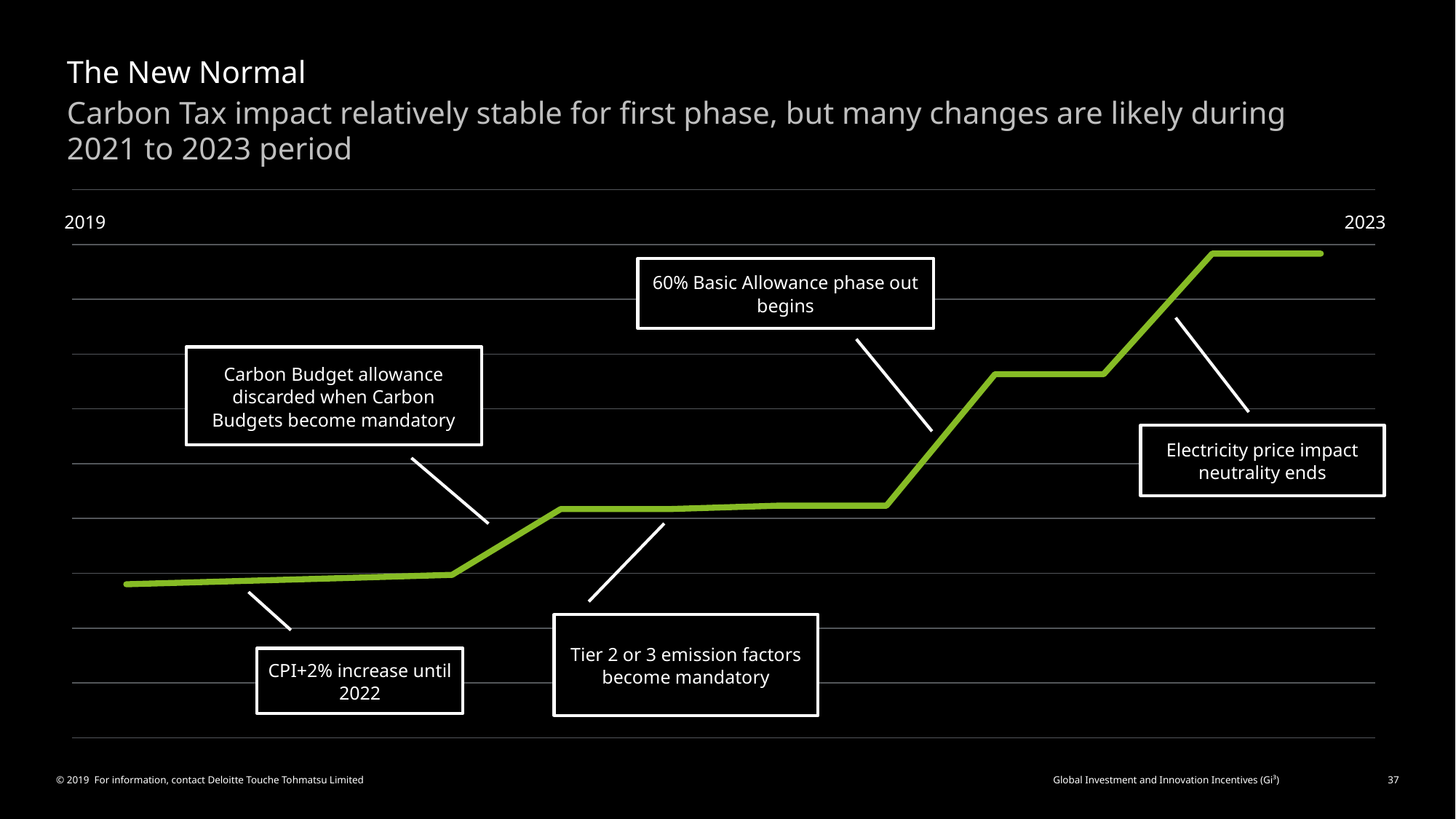
Does the line ever decrease between 2019 and 2023? no What are the first and last year labels shown on the x axis? 2019 and 2023 How many annotation boxes are attached to the line? 5 Which is higher, the value of the line at 2019 or at 2023? 2023 Do the values on the line rise or fall from 2019 to 2023? rise What kind of chart is shown on the slide? line chart